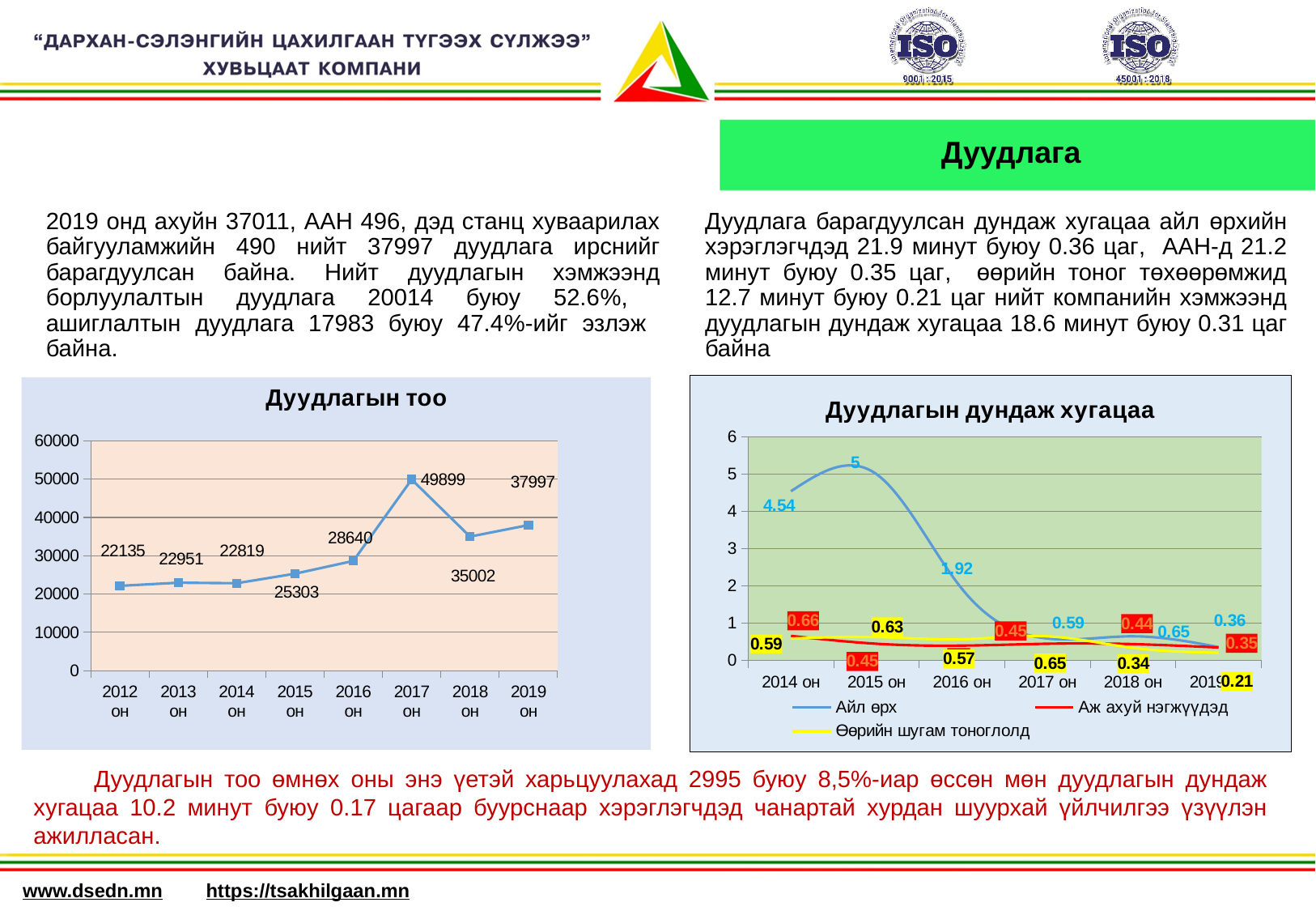
In the chart titled "Дуудлагын тоо", which year has the highest value? 2017 он In the chart titled "Дуудлагын тоо", which year has the lowest value? 2012 он In the chart titled "Дуудлагын тоо", how many years are plotted? 8 In the chart titled "Дуудлагын дундаж хугацаа", does the Айл өрх series rise or fall from 2015 он to 2019 он? Fall In the chart titled "Дуудлагын дундаж хугацаа", how many series does the legend list? 3 In the chart titled "Дуудлагын тоо", what is the difference between the values for 2017 он and 2018 он? 14897 In the chart titled "Дуудлагын тоо", what is the value for 2012 он? 22135 In the chart titled "Дуудлагын тоо", what is the value for 2017 он? 49899 In the chart titled "Дуудлагын дундаж хугацаа", what is the value of the Айл өрх series for 2014 он? 4.54 In the chart titled "Дуудлагын тоо", which is larger, the value for 2019 он or the value for 2018 он? 2019 он In the chart titled "Дуудлагын дундаж хугацаа", what is the value of the Айл өрх series for 2015 он? 5 What kind of chart is "Дуудлагын тоо"? Line chart